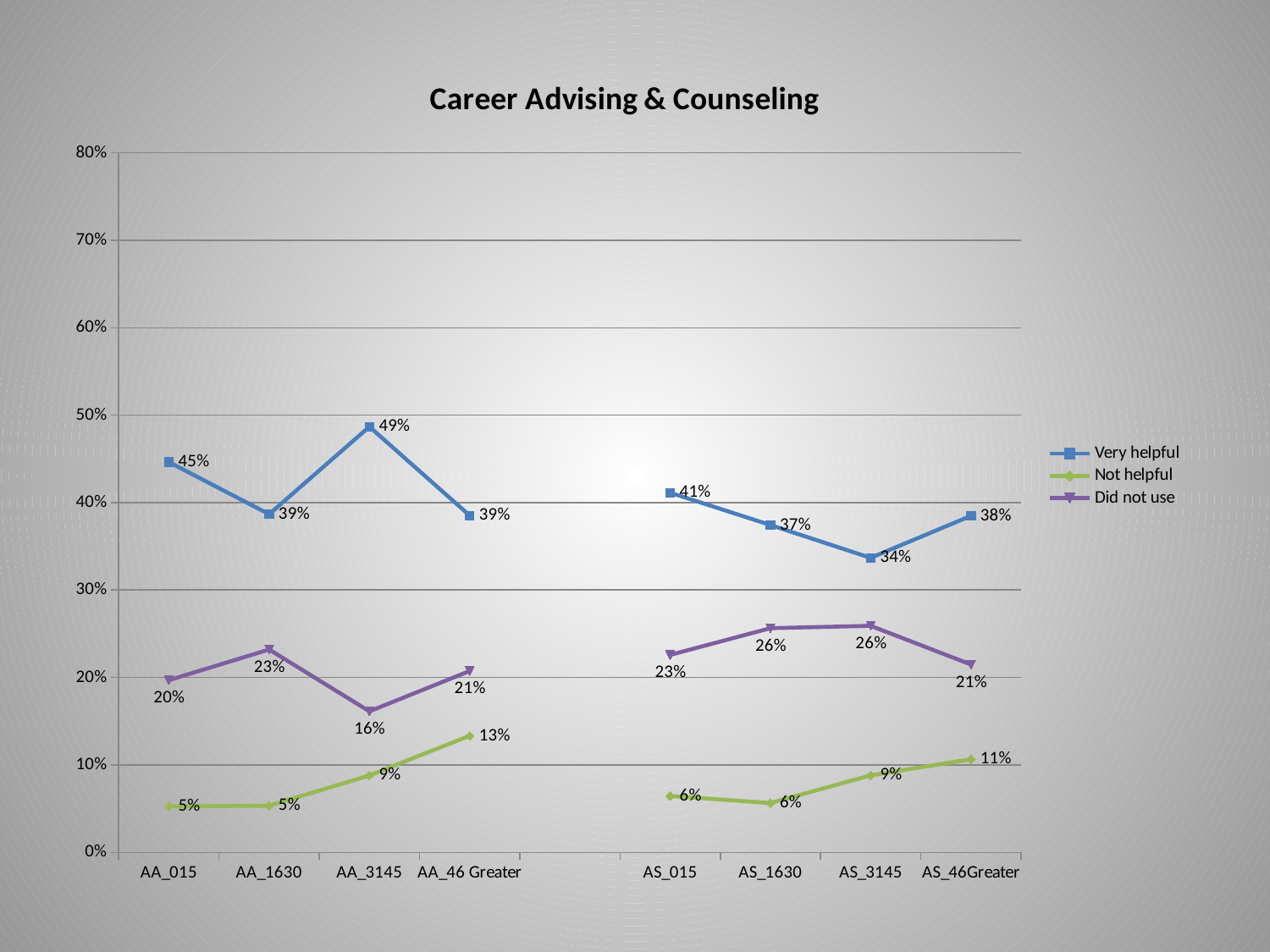
Which category has the lowest Very helpful value? AS_3145 What is the difference between the Very helpful values for AA_015 and AS_015? 4% Does the Not helpful series rise or fall from AS_1630 to AS_46Greater? Rise What is the Did not use value for AS_1630? 26% Which series is drawn in green? Not helpful What is the title of the chart? Career Advising & Counseling What is the Not helpful value for AA_46 Greater? 13% Which is larger, the Did not use value for AA_3145 or for AS_3145? AS_3145 What is the Very helpful value for AA_3145? 49% Which category has the highest Very helpful value? AA_3145 What kind of chart is shown on the slide? Line chart How many series does the legend list? 3